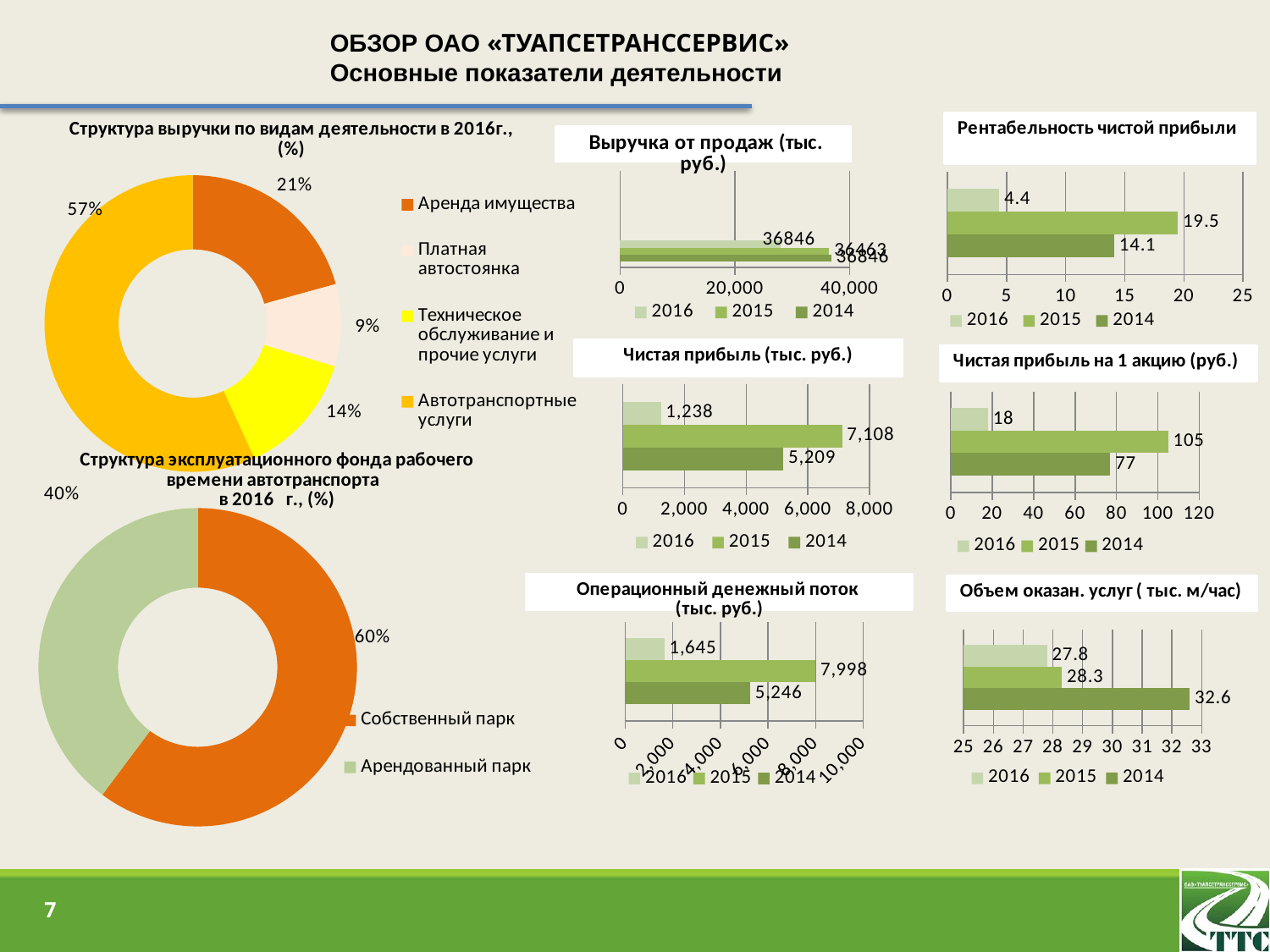
In the chart 'Структура выручки по видам деятельности в 2016г.', what share does 'Автотранспортные услуги' have? 57% In the chart 'Объем оказан. услуг (тыс. м/час)', which is larger, the value for 2014 or for 2016? 2014 In the chart 'Чистая прибыль (тыс. руб.)', what is the difference between the 2015 and 2016 values? 5,870 In the chart 'Структура выручки по видам деятельности в 2016г.', which category has the smallest share? Платная автостоянка In the chart 'Чистая прибыль на 1 акцию (руб.)', which year has the highest value? 2015 How many series does the legend of the chart 'Объем оказан. услуг (тыс. м/час)' list? 3 In the chart 'Рентабельность чистой прибыли', what is the value for 2015? 19.5 What kind of chart is 'Структура эксплуатационного фонда рабочего времени автотранспорта в 2016 г.'? Donut (pie) chart In the chart 'Структура эксплуатационного фонда рабочего времени автотранспорта в 2016 г.', what is the share of 'Собственный парк'? 60% In the chart 'Чистая прибыль (тыс. руб.)', what is the value for 2014? 5,209 In the chart 'Рентабельность чистой прибыли', which year has the lowest value? 2016 In the chart 'Операционный денежный поток (тыс. руб.)', what is the value for 2016? 1,645